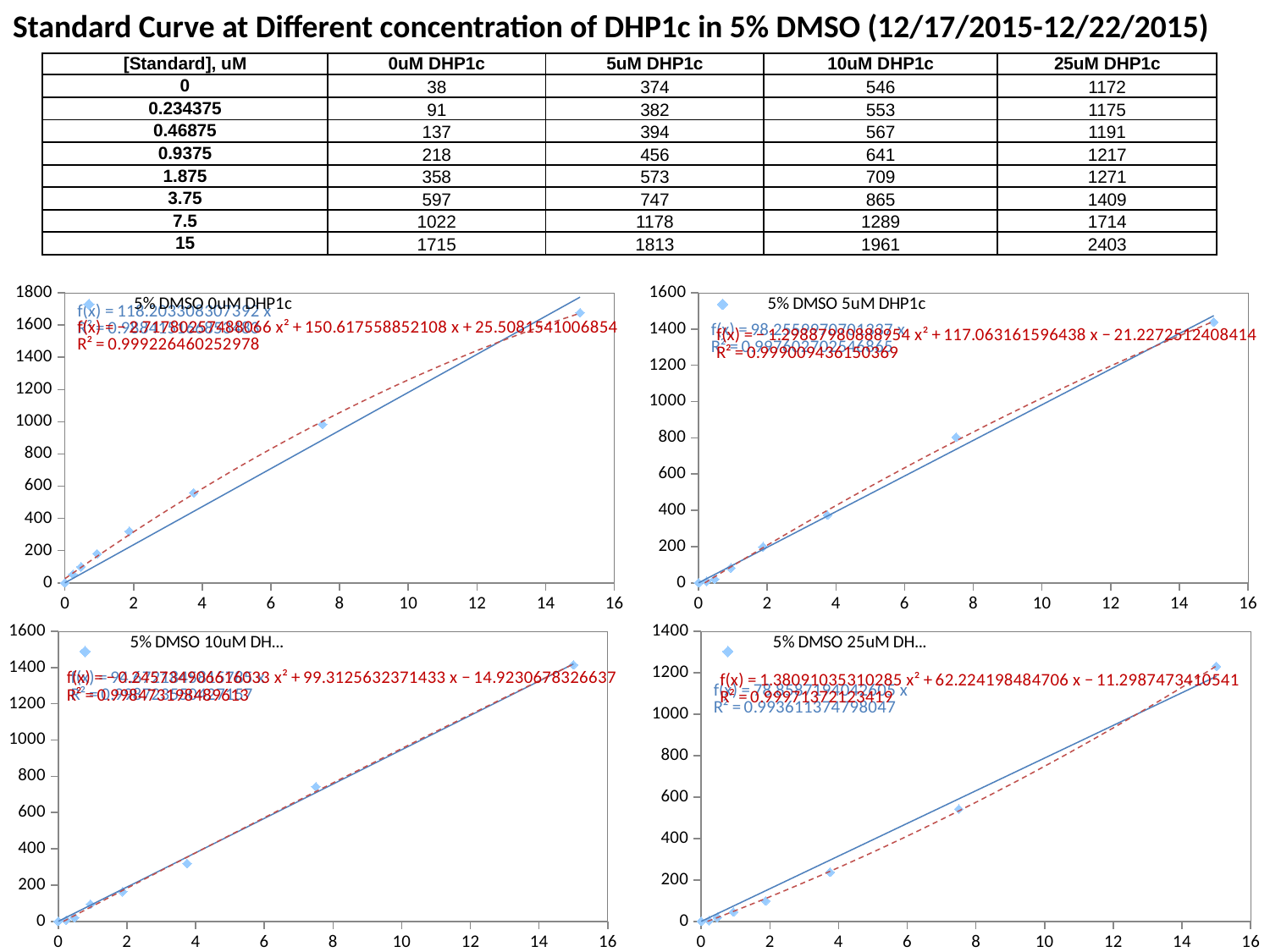
What kind of chart is the top-left chart titled "5% DMSO 0uM DHP1c"? Scatter chart How many data points are plotted in the top-left chart titled "5% DMSO 0uM DHP1c"? 8 In the top-right chart titled "5% DMSO 5uM DHP1c", is the value at x = 15 greater or less than 1400? greater In the top-right chart titled "5% DMSO 5uM DHP1c", is the value at x = 3.75 greater or less than 400? less In the top-left chart titled "5% DMSO 0uM DHP1c", is the value at x = 15 greater or less than 1600? greater In the top-left chart titled "5% DMSO 0uM DHP1c", do the values rise or fall as x increases? Rise What R² value is printed in red on the top-left chart titled "5% DMSO 0uM DHP1c"? 0.999226460252978 What is the highest value shown on the y axis of the top-right chart titled "5% DMSO 5uM DHP1c"? 1600